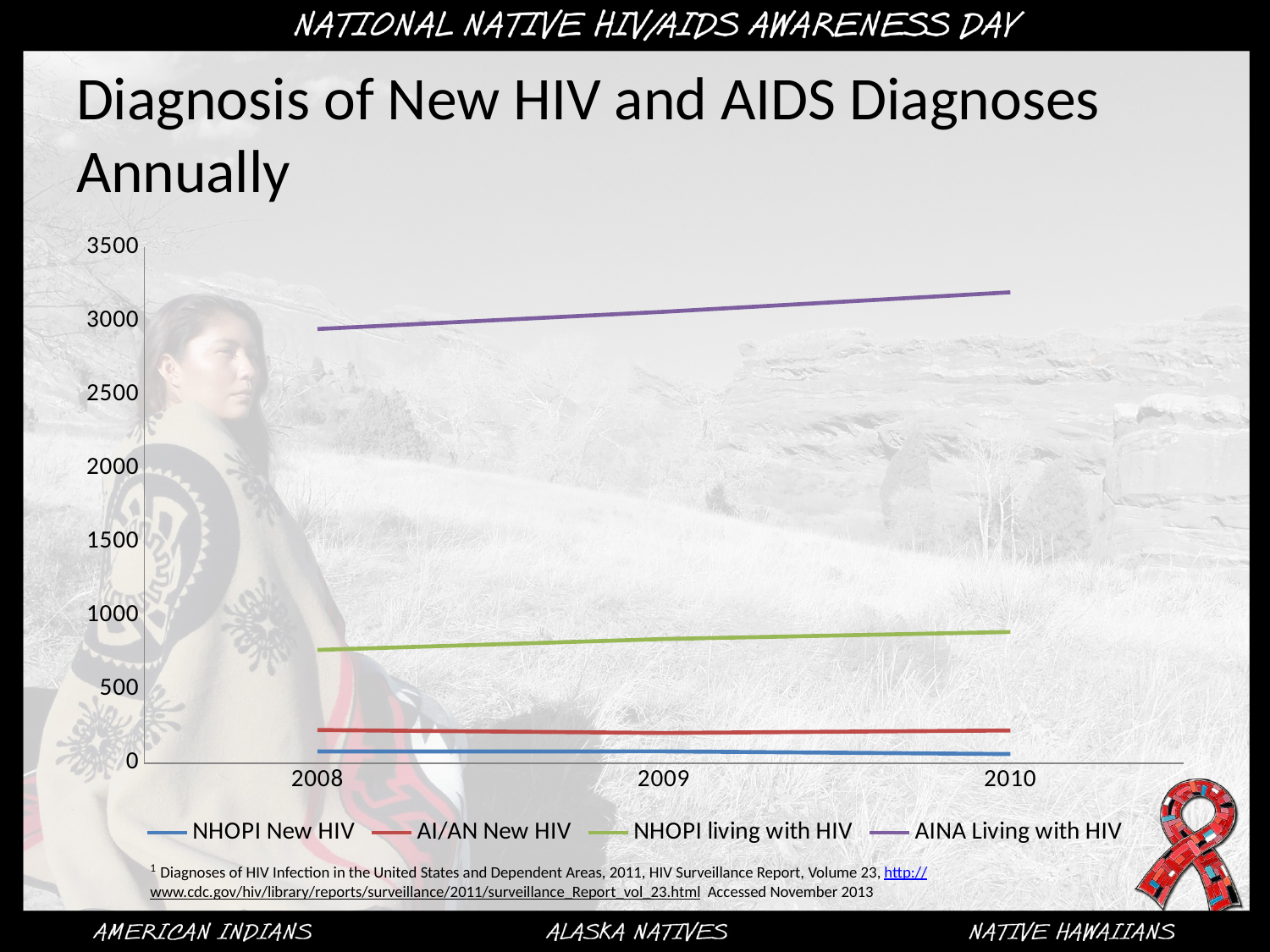
What colour is the line for NHOPI living with HIV? green What kind of chart is shown on the slide? line chart How many years are shown on the x axis? 3 Which series has the lowest values across all years? NHOPI New HIV Does the AINA Living with HIV line rise or fall from 2008 to 2010? rise In 2009, which is larger: AI/AN New HIV or NHOPI New HIV? AI/AN New HIV Does the NHOPI living with HIV line rise or fall from 2008 to 2010? rise Is the value for AI/AN New HIV in 2009 greater or less than 500? less How many series does the legend list? 4 Is the value for AINA Living with HIV in 2010 greater or less than 3000? greater Is the value for NHOPI living with HIV in 2010 greater or less than 1000? less Which series has the highest values across all years? AINA Living with HIV